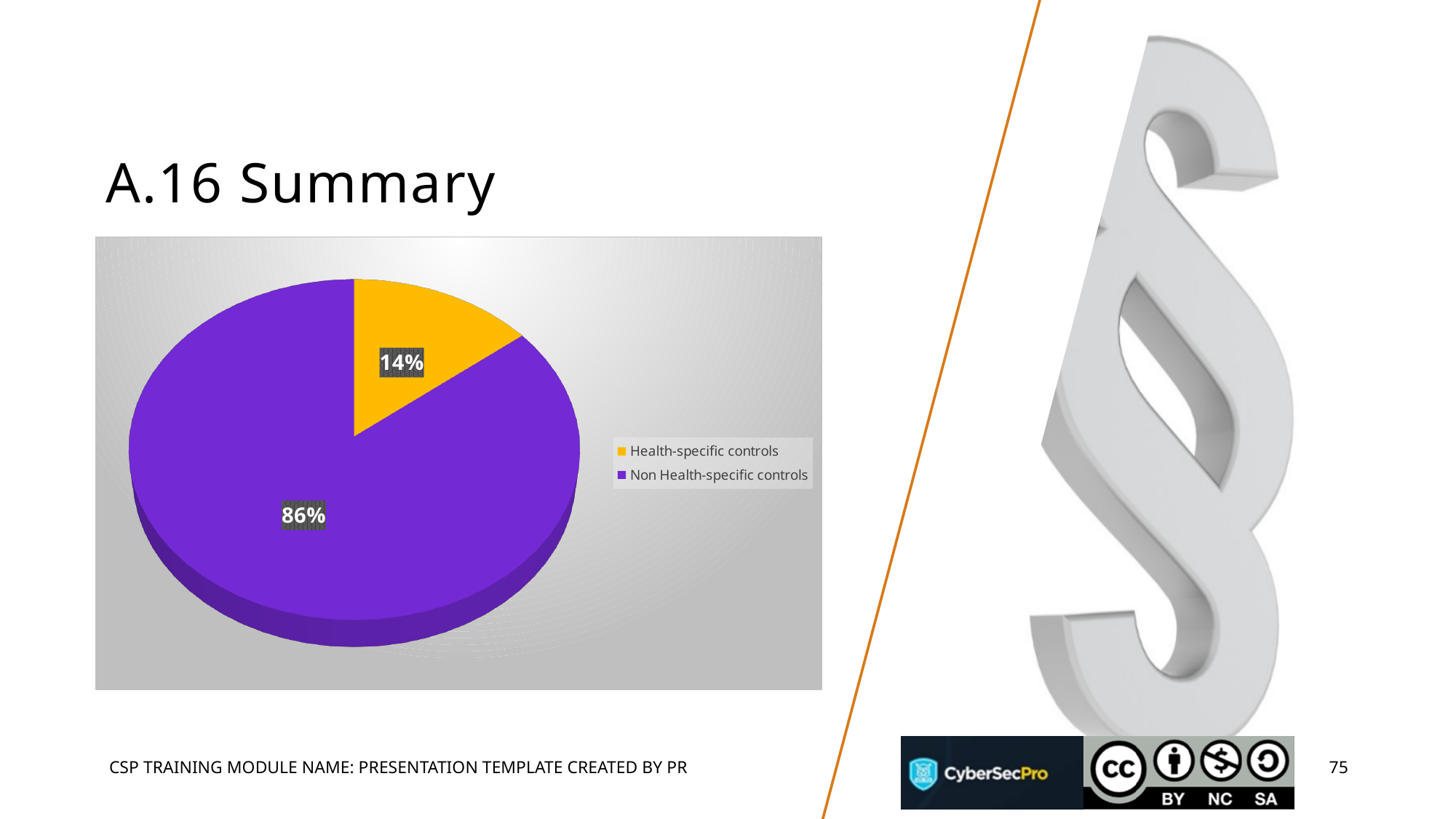
What kind of chart is shown on the slide? pie chart What colour is the slice for Health-specific controls? yellow Which category has the largest share of the pie? Non Health-specific controls Which is larger: the share for Health-specific controls or the share for Non Health-specific controls? Non Health-specific controls Which category has the smallest share of the pie? Health-specific controls How many slices does the pie chart have? 2 What colour is the slice for Non Health-specific controls? purple How many entries does the legend list? 2 What is the difference in percentage points between Non Health-specific controls and Health-specific controls? 72 What percentage of the pie is Health-specific controls? 14% What percentage of the pie is Non Health-specific controls? 86%